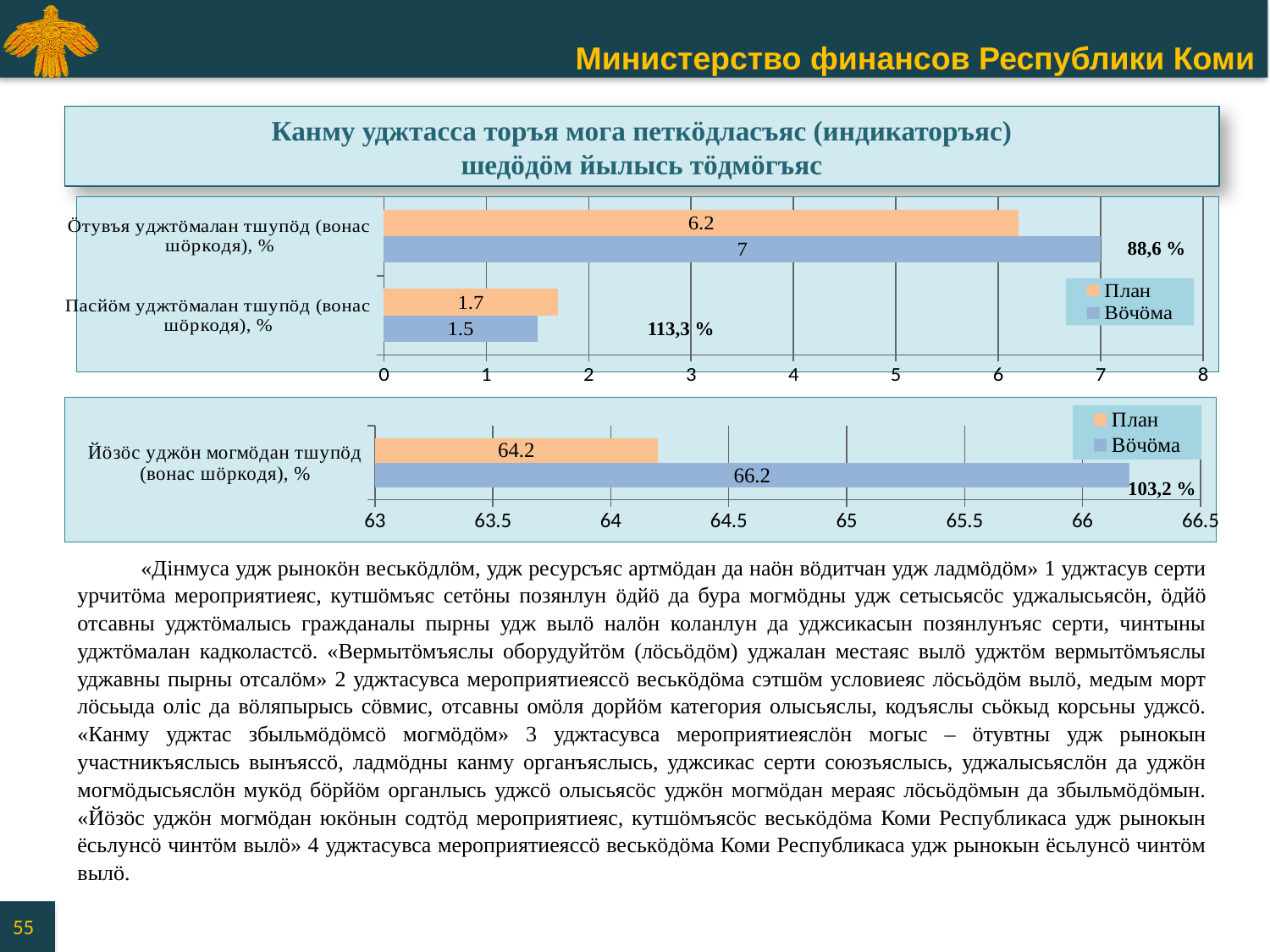
In the bottom chart, what is the План value for Йӧзӧс уджӧн могмӧдан тшупӧд (вонас шӧркодя), %? 64.2 In the top chart, what is the План value for Ӧтувъя уджтӧмалан тшупӧд (вонас шӧркодя), %? 6.2 How many categories are shown in the top chart? 2 In the top chart, which is larger for Пасйӧм уджтӧмалан тшупӧд (вонас шӧркодя), %: План or Вӧчӧма? План In the top chart, what is the План value for Пасйӧм уджтӧмалан тшупӧд (вонас шӧркодя), %? 1.7 What kind of chart is the bottom chart? Bar chart In the bottom chart, what is the Вӧчӧма value for Йӧзӧс уджӧн могмӧдан тшупӧд (вонас шӧркодя), %? 66.2 In the top chart, what is the Вӧчӧма value for Ӧтувъя уджтӧмалан тшупӧд (вонас шӧркодя), %? 7 In the top chart, what is the difference between the Вӧчӧма and План values for Ӧтувъя уджтӧмалан тшупӧд (вонас шӧркодя), %? 0.8 In the bottom chart, what is the difference between the Вӧчӧма and План values? 2 In the top chart, what is the Вӧчӧма value for Пасйӧм уджтӧмалан тшупӧд (вонас шӧркодя), %? 1.5 How many series does the legend of the top chart list? 2